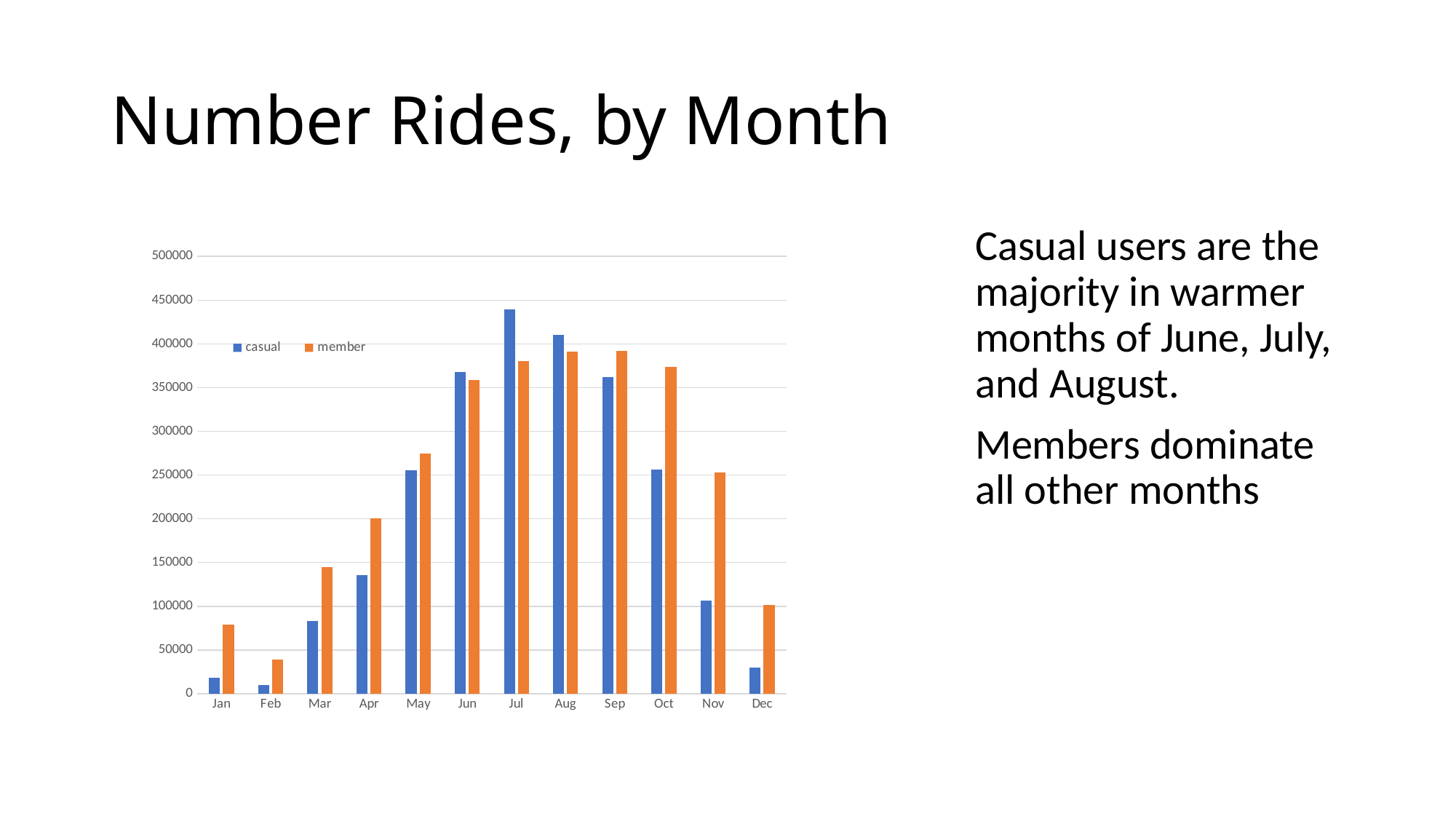
What kind of chart is shown on the slide? bar chart Which month has the lowest number of casual rides? Feb In Jul, which series has more rides, casual or member? casual Is the value for member rides in Oct greater or less than 350000? greater Which month has the lowest number of member rides? Feb Is the value for casual rides in Dec greater or less than 50000? less Do casual rides rise or fall from Jan to Jul? rise In Oct, which series has more rides, casual or member? member Which month has the highest number of casual rides? Jul How many months are shown on the x axis? 12 Is the value for casual rides in Jul greater or less than 400000? greater How many series does the legend list? 2